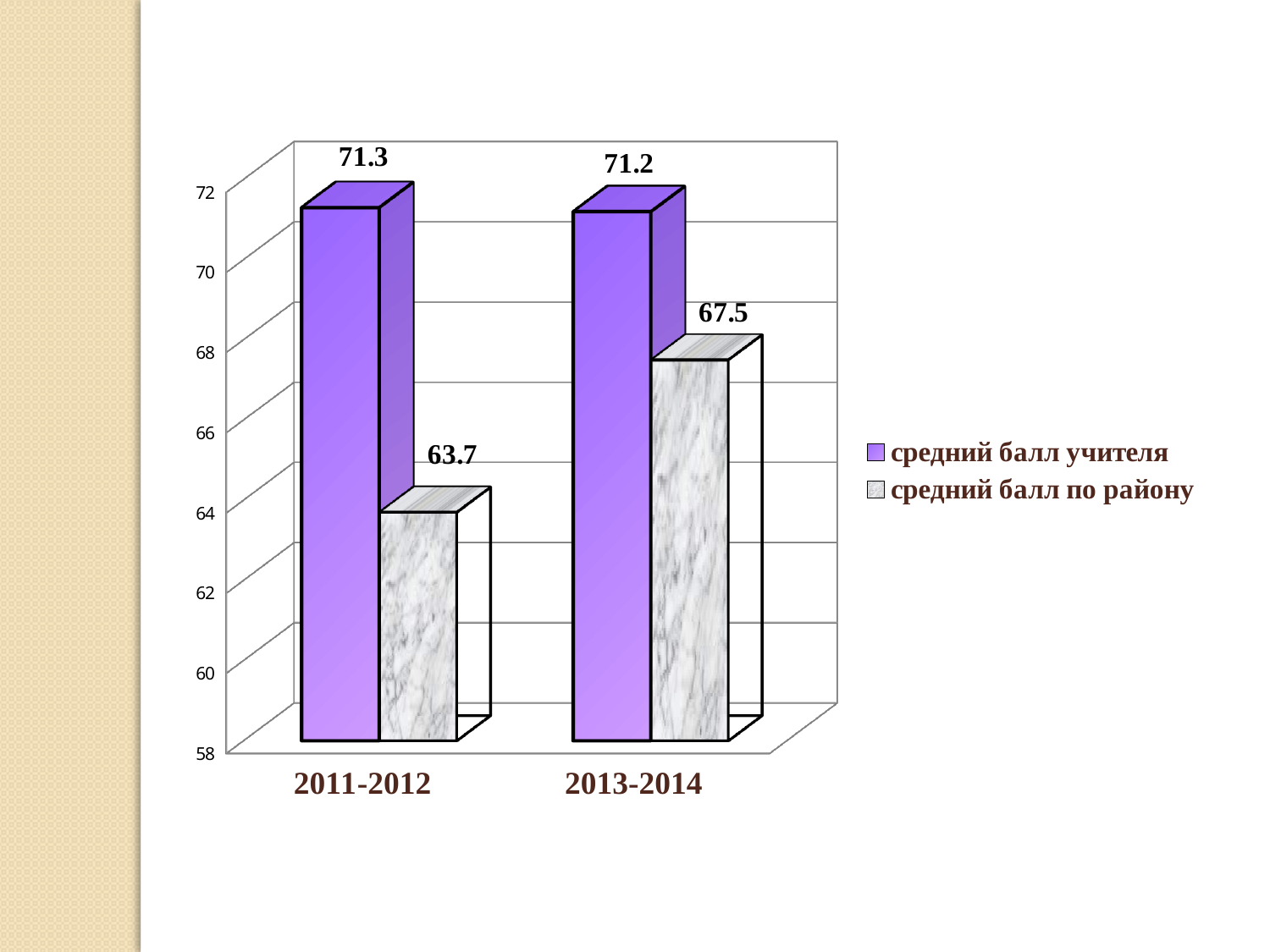
Does 'средний балл по району' rise or fall from 2011-2012 to 2013-2014? rise What is the difference between 'средний балл учителя' and 'средний балл по району' in 2013-2014? 3.7 What is the value of 'средний балл учителя' for 2011-2012? 71.3 What is the difference between 'средний балл учителя' and 'средний балл по району' in 2011-2012? 7.6 How many series does the legend list? 2 What kind of chart is shown on the slide? bar chart What is the value of 'средний балл по району' for 2013-2014? 67.5 How many categories are shown on the x axis? 2 Which is larger in 2013-2014: 'средний балл учителя' or 'средний балл по району'? средний балл учителя What is the value of 'средний балл по району' for 2011-2012? 63.7 Which category has the lowest value for 'средний балл по району'? 2011-2012 What is the value of 'средний балл учителя' for 2013-2014? 71.2